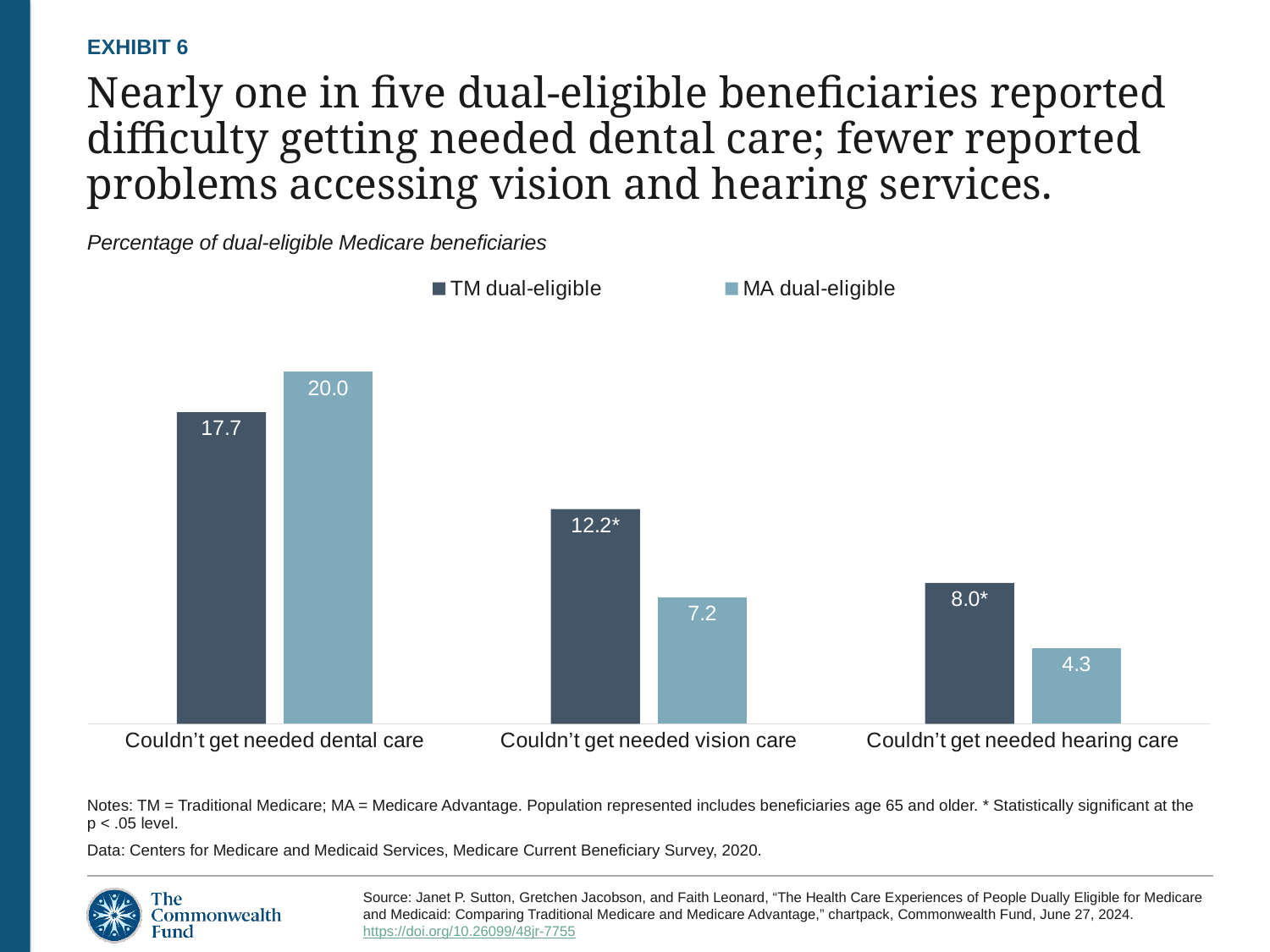
What is the value for MA dual-eligible beneficiaries who couldn't get needed dental care? 20.0 Which is larger for couldn't get needed dental care: the TM dual-eligible value or the MA dual-eligible value? MA dual-eligible What are the two series named in the legend? TM dual-eligible and MA dual-eligible What kind of chart is shown on the slide? Bar chart Which category has the lowest value for TM dual-eligible beneficiaries? Couldn't get needed hearing care How many series does the legend list? 2 What is the value for TM dual-eligible beneficiaries who couldn't get needed vision care? 12.2* What is the value for MA dual-eligible beneficiaries who couldn't get needed hearing care? 4.3 Which category has the highest value for MA dual-eligible beneficiaries? Couldn't get needed dental care How many categories are shown on the x axis? 3 What is the difference between the TM dual-eligible and MA dual-eligible values for couldn't get needed vision care? 5.0 What is the value for TM dual-eligible beneficiaries who couldn't get needed dental care? 17.7